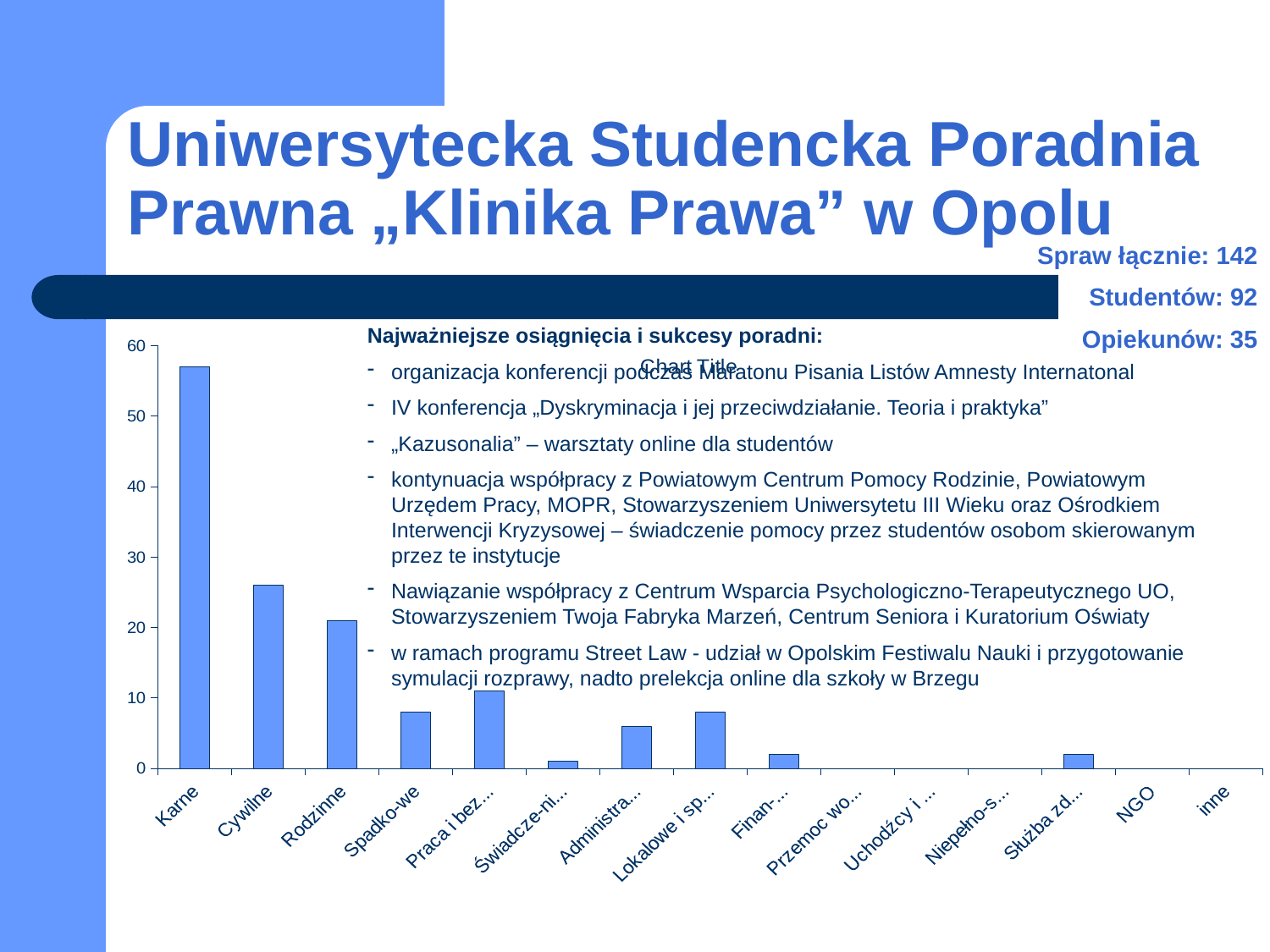
How many categories are shown on the x axis of the chart? 15 What is the title shown on the chart? Chart Title Which is larger, the value for Administra... or the value for Świadcze-ni...? Administra... Which category has the highest bar in the chart? Karne Is the value for Cywilne greater or less than 20? greater Is the value for Rodzinne greater or less than 30? less Which is larger, the value for Karne or the value for Cywilne? Karne What kind of chart is shown on the slide? bar chart Is the value for Spadko-we greater or less than 10? less Which is larger, the value for Cywilne or the value for Rodzinne? Cywilne